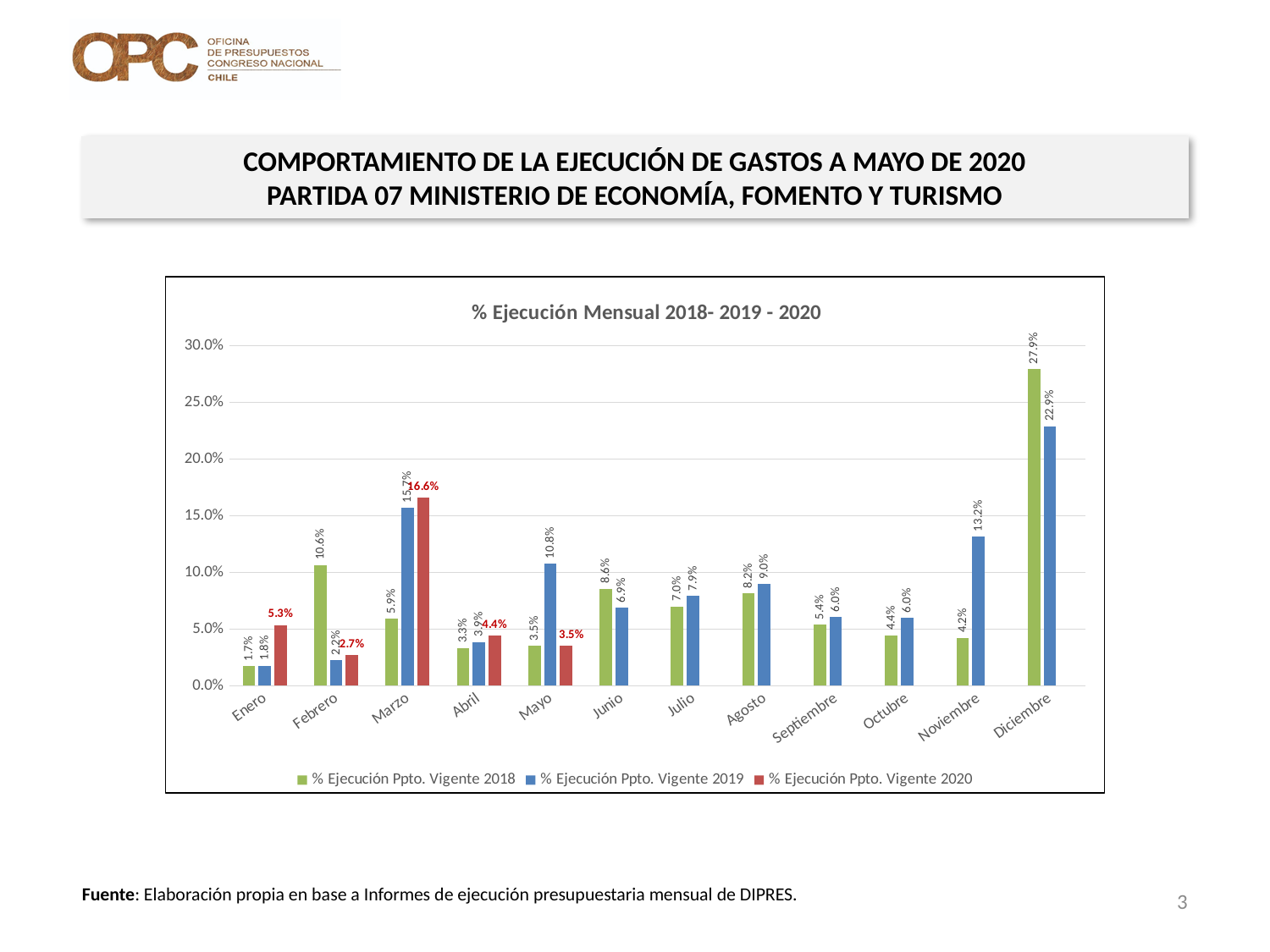
Is the value for Diciembre in the 2019 series greater or less than 20.0%? greater What is the value for Marzo in the % Ejecución Ppto. Vigente 2020 series? 16.6% What is the difference between the 2019 and 2018 values for Mayo? 7.3% What is the value for Noviembre in the % Ejecución Ppto. Vigente 2019 series? 13.2% What kind of chart is shown on the slide? Bar chart What is the value for Diciembre in the % Ejecución Ppto. Vigente 2018 series? 27.9% How many series does the legend list? 3 What is the title of the chart? % Ejecución Mensual 2018- 2019 - 2020 Which is larger for Febrero: the 2018 value or the 2019 value? 2018 Which month has the highest value in the % Ejecución Ppto. Vigente 2019 series? Diciembre How many months are shown on the x axis? 12 Which month has the lowest value in the % Ejecución Ppto. Vigente 2018 series? Enero